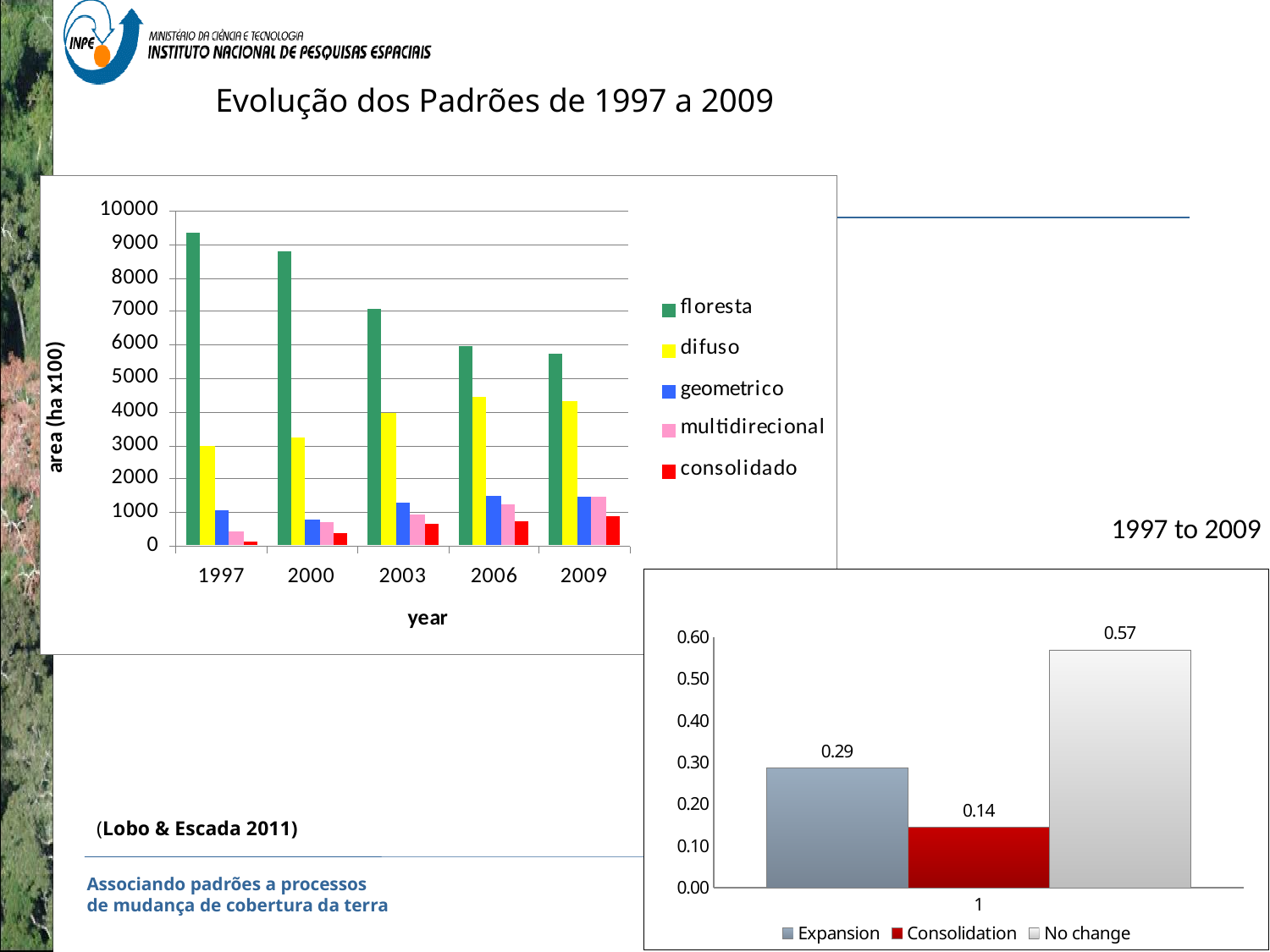
On the top-left chart (area by year), does the floresta series rise or fall from 1997 to 2009? fall On the bottom-right chart, how many series does the legend list? 3 On the bottom-right chart, what is the value for Expansion? 0.29 On the bottom-right chart, what is the value for Consolidation? 0.14 On the top-left chart (area by year), how many years are shown on the x axis? 5 On the top-left chart (area by year), how many series does the legend list? 5 On the bottom-right chart, which category has the highest value? No change On the bottom-right chart, which category has the lowest value? Consolidation On the bottom-right chart, what is the difference between the No change value and the Expansion value? 0.28 On the top-left chart (area by year), is the value for floresta in 1997 greater or less than 9000? greater On the bottom-right chart, what is the value for No change? 0.57 On the top-left chart (area by year), which is larger in 2009: difuso or geometrico? difuso